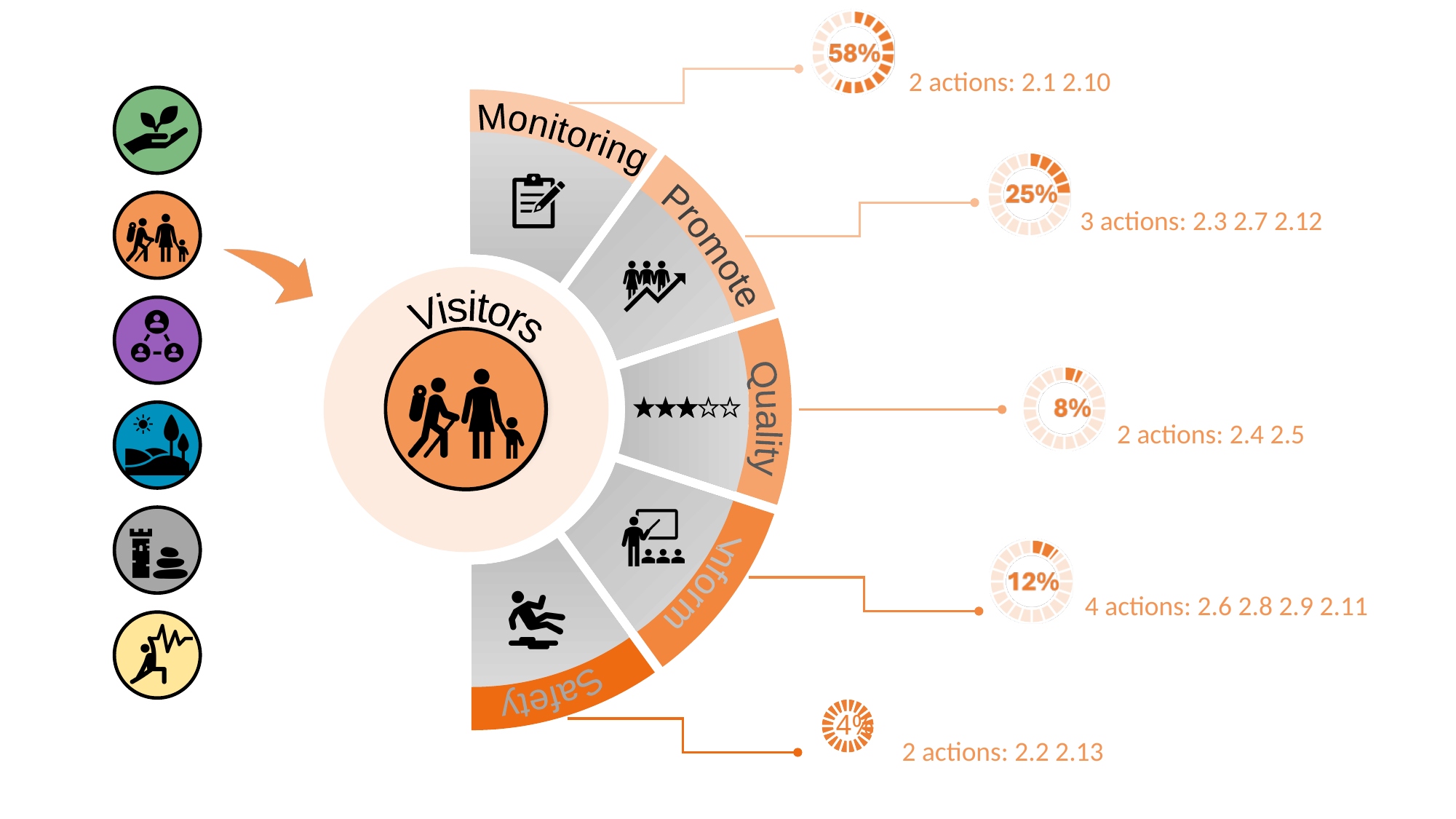
Which actions are listed for the Promote segment? 2.3 2.7 2.12 What percentage is shown in the ring chart for the Promote segment? 25% Which segment has the lowest percentage in its ring chart? Safety How many actions are listed for the Inform segment? 4 What percentage is shown in the ring chart for the Inform segment? 12% How many segments are shown around the Visitors semicircle? 5 Which segment has the highest percentage in its ring chart? Monitoring What percentage is shown in the ring chart for the Monitoring segment? 58% What is the difference between the Monitoring percentage and the Promote percentage? 33% What percentage is shown in the ring chart for the Quality segment? 8% Which has the larger percentage, Inform or Quality? Inform What is the label in the centre of the semicircular diagram? Visitors